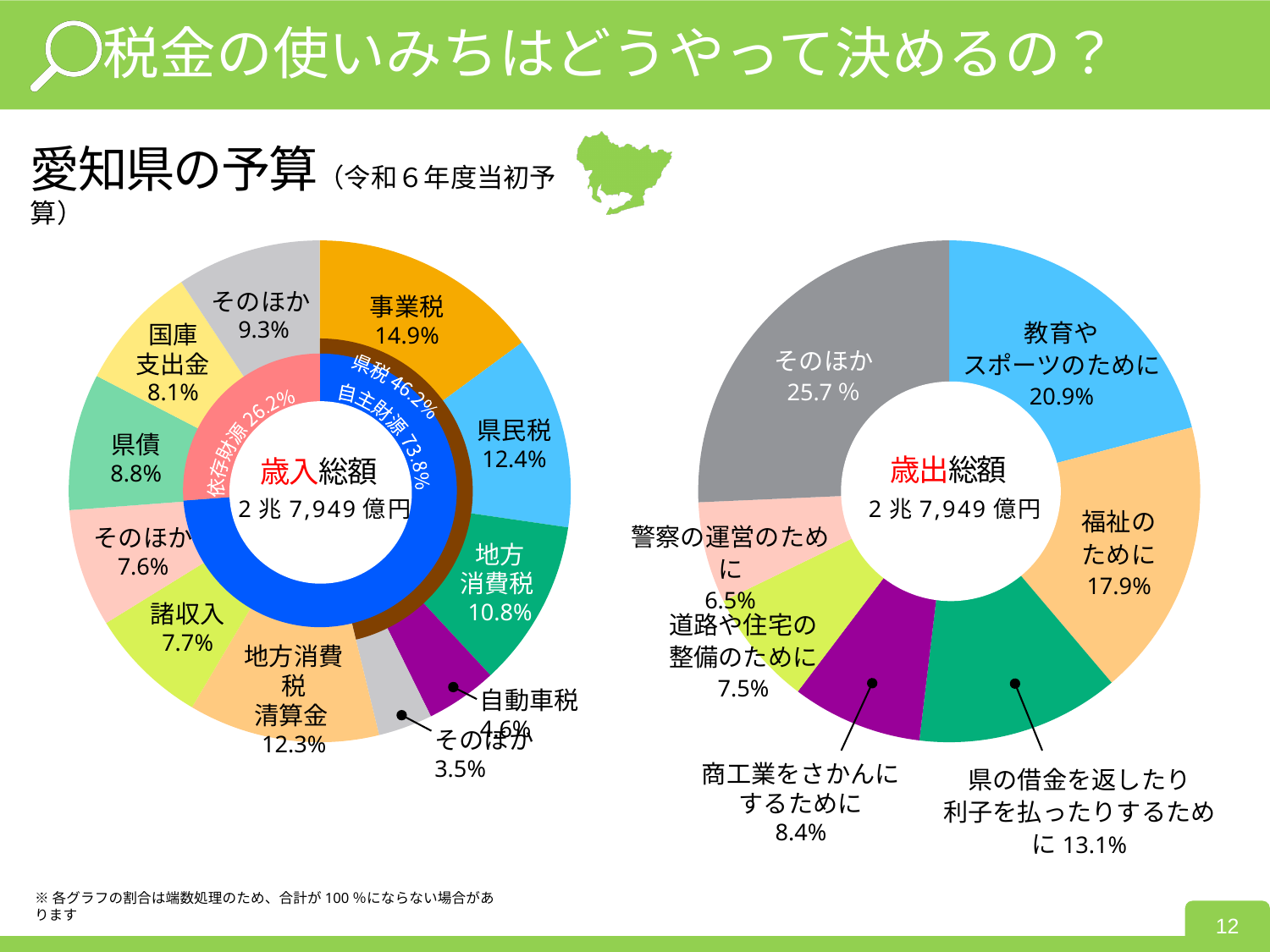
In the 歳出総額 chart on the right, how many categories are shown? 7 What total amount is shown in the centre of the 歳入総額 chart on the left? 2兆7,949億円 In the 歳出総額 chart on the right, which category has the smallest share? 警察の運営のために In the 歳出総額 chart on the right, which named purpose (excluding そのほか) has the largest share? 教育やスポーツのために In the 歳入総額 chart on the left, what share is 国庫支出金? 8.1% In the 歳入総額 chart on the left, which is larger, 県民税 or 地方消費税? 県民税 In the 歳入総額 chart on the left, what share of the inner ring is 自主財源? 73.8% In the 歳出総額 chart on the right, what share is 福祉のために? 17.9% In the 歳入総額 chart on the left, what share is 事業税? 14.9% What kind of chart is used for 歳出総額 on the right? Pie chart In the 歳出総額 chart on the right, what is the difference between 福祉のために and 商工業をさかんにするために? 9.5% In the 歳出総額 chart on the right, what share is 教育やスポーツのために? 20.9%